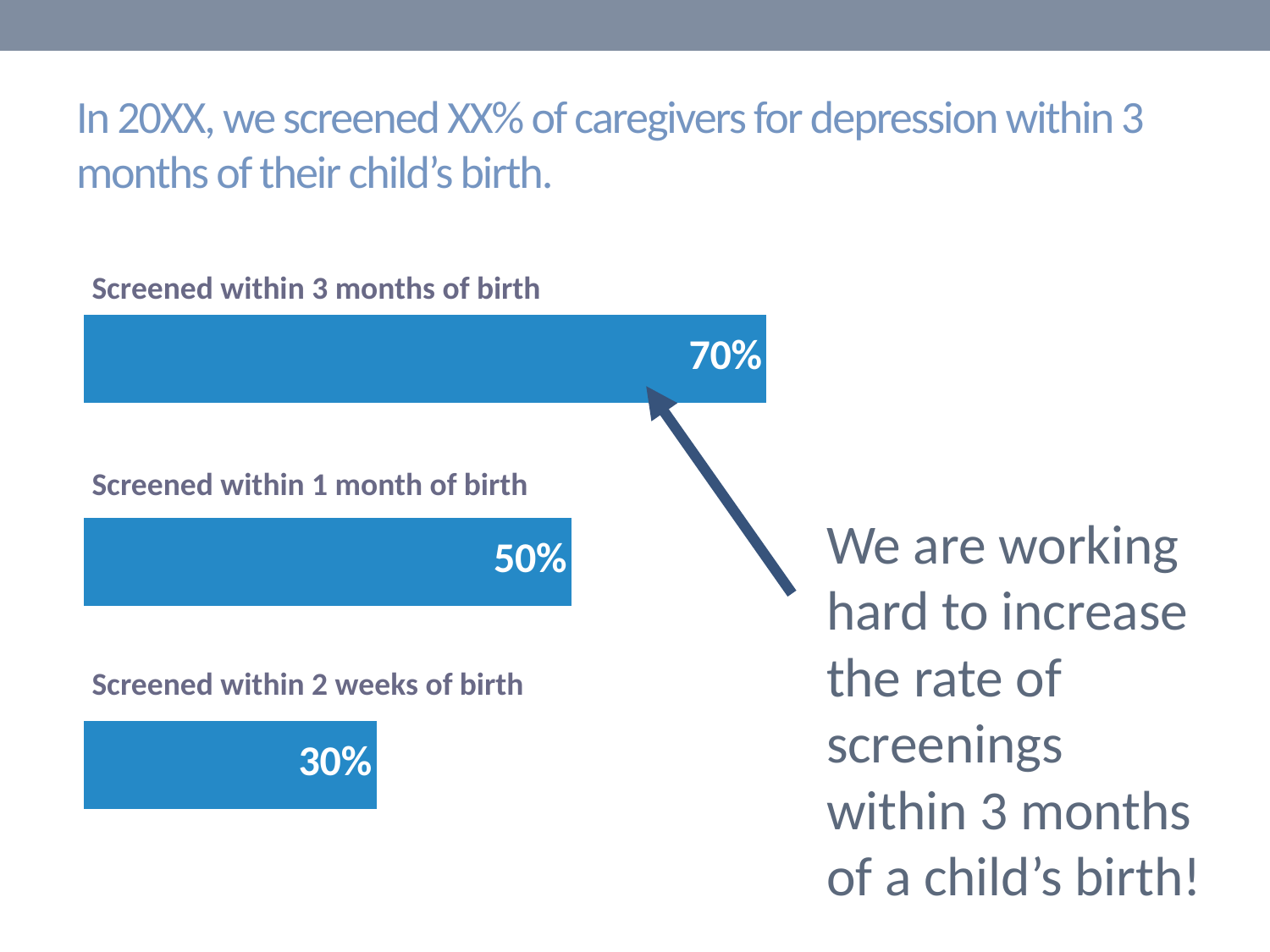
Which is larger: the value for screened within 1 month of birth or screened within 2 weeks of birth? Screened within 1 month of birth How many categories are shown in the chart? 3 What percentage of caregivers were screened within 2 weeks of birth? 30% What is the difference between the value for screened within 1 month of birth and screened within 2 weeks of birth? 20% Which category has the highest value? Screened within 3 months of birth What colour are the bars in the chart? Blue What kind of chart is shown on the slide? Bar chart Which category has the lowest value? Screened within 2 weeks of birth What percentage of caregivers were screened within 1 month of birth? 50% What percentage of caregivers were screened within 3 months of birth? 70% Are the bars in the chart horizontal or vertical? Horizontal What is the difference between the value for screened within 3 months of birth and screened within 2 weeks of birth? 40%